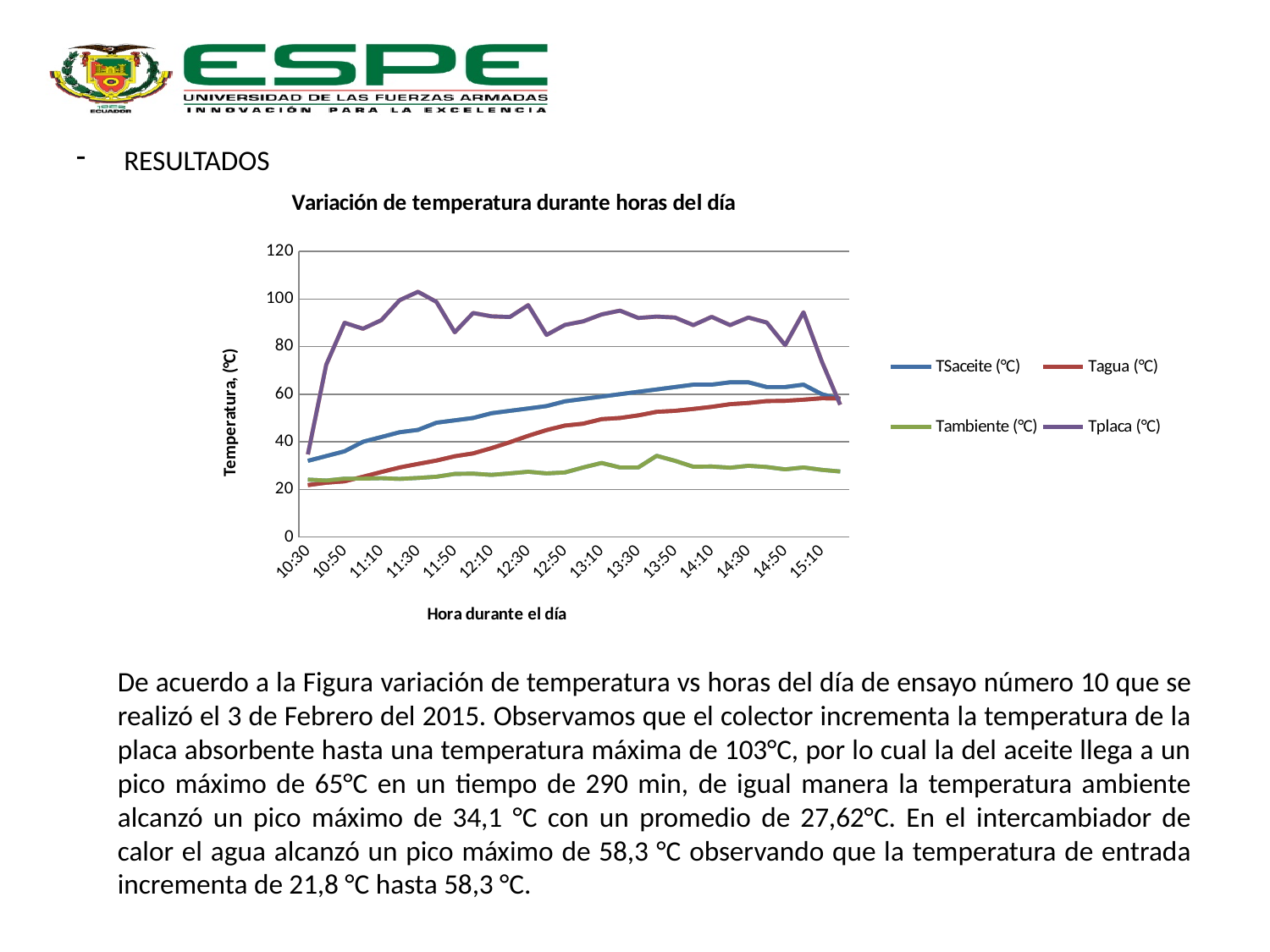
Is the value of TSaceite (°C) at 10:30 greater or less than 40? less How many series does the legend list? 4 At 10:30, which is larger: TSaceite (°C) or Tagua (°C)? TSaceite (°C) Does the Tagua (°C) series rise or fall from 10:30 to 15:10? rise What is the title of the chart? Variación de temperatura durante horas del día Which series reaches the highest temperature on the chart? Tplaca (°C) What kind of chart is shown on the slide? line chart How many time labels are shown along the x axis? 15 Is the value of Tagua (°C) at 15:10 greater or less than 40? greater Is the value of Tplaca (°C) at 10:50 greater or less than 80? greater What is the label of the vertical axis? Temperatura, (°C)